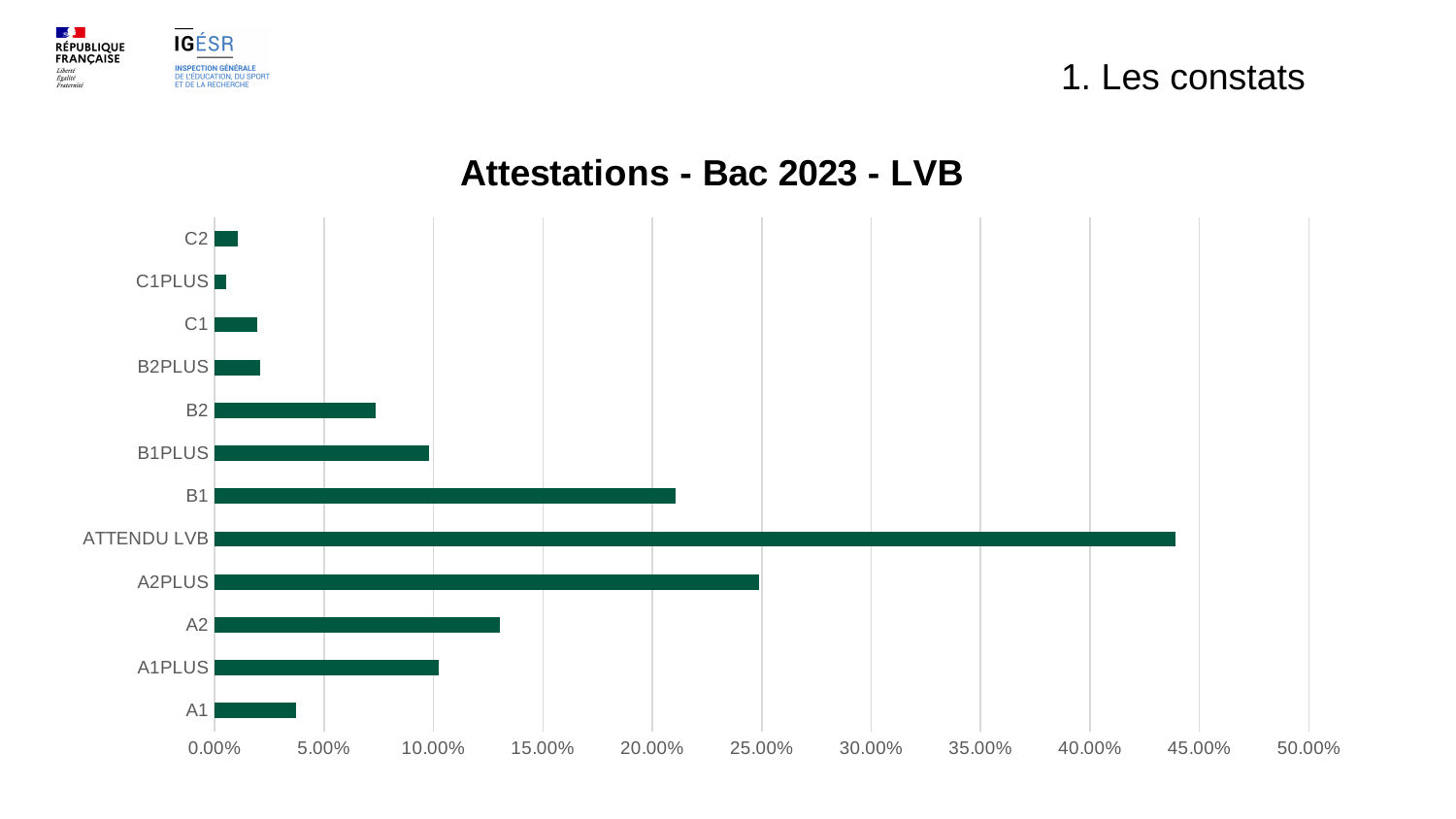
Which category has the highest value? ATTENDU LVB Is the value for B1 greater or less than 20.00%? greater Is the value for A2 greater or less than 10.00%? greater What type of chart is shown on the slide? bar chart How many categories are plotted on the chart? 12 Is the value for B2 greater or less than 10.00%? less Which has a larger value, B2 or B1PLUS? B1PLUS Which has a larger value, B1 or A2PLUS? A2PLUS What is the title of the chart? Attestations - Bac 2023 - LVB Which category has the lowest value? C1PLUS